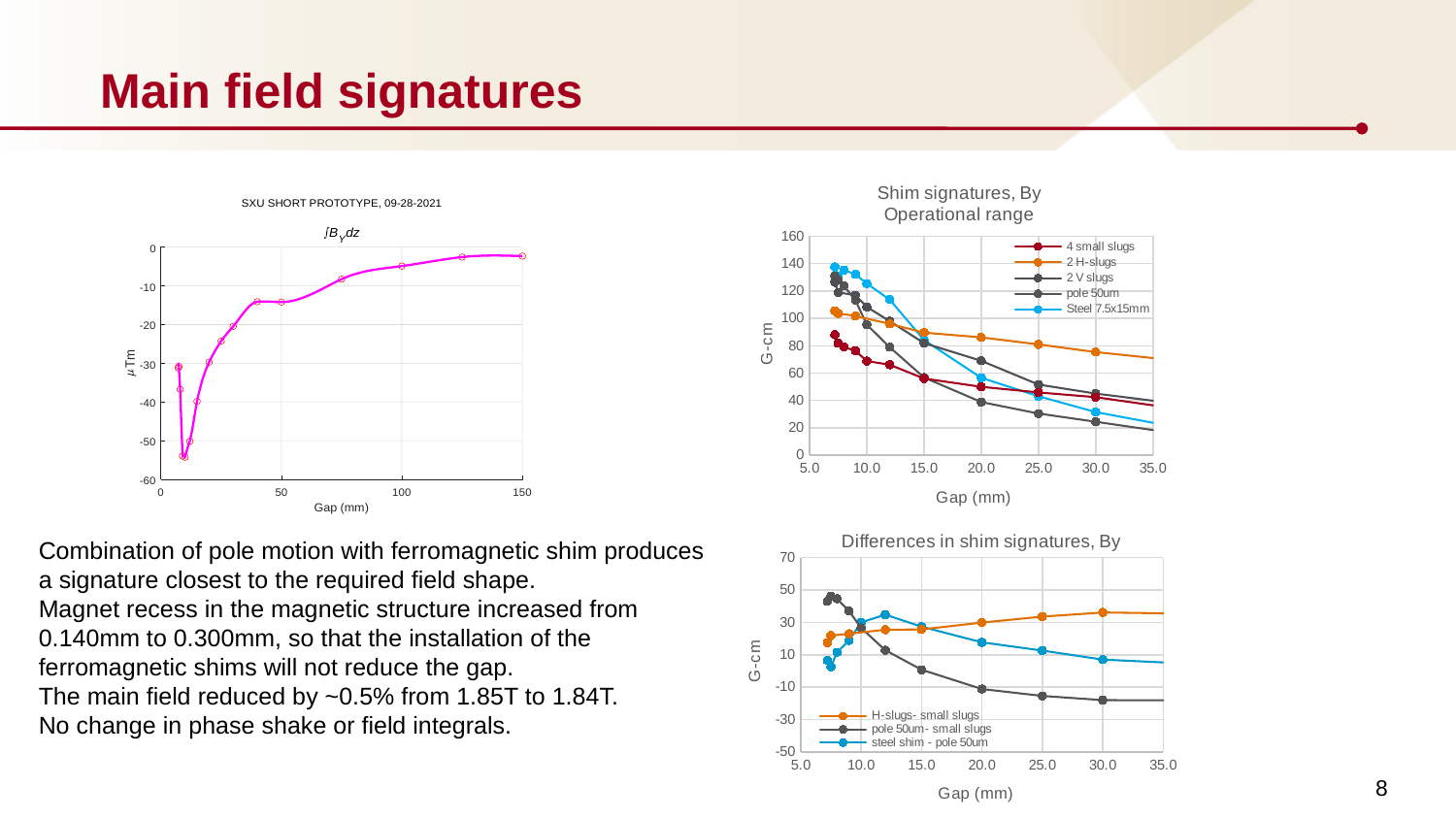
In the 'Differences in shim signatures, By' chart, is the value of the 'pole 50um- small slugs' series at a gap of 30.0 mm greater or less than -10? less In the 'SXU SHORT PROTOTYPE, 09-28-2021' chart, is the value at a gap of 100 mm greater or less than -10? greater What kind of chart is 'Differences in shim signatures, By'? line chart In the 'Differences in shim signatures, By' chart, does the 'H-slugs- small slugs' series rise or fall as the gap increases from 10.0 to 30.0 mm? rise In the 'Shim signatures, By Operational range' chart, is the value of the 4 small slugs series at a gap of 10.0 mm greater or less than 80? less In the 'Shim signatures, By Operational range' chart, which series has the highest value at a gap of 35.0 mm? 2 H-slugs What is the x-axis label of the 'SXU SHORT PROTOTYPE, 09-28-2021' chart? Gap (mm) In the 'Shim signatures, By Operational range' chart, at a gap of 15.0 mm, which is larger: the 2 H-slugs value or the 4 small slugs value? 2 H-slugs In the 'Shim signatures, By Operational range' chart, does the Steel 7.5x15mm series rise or fall as the gap increases? fall In the 'Differences in shim signatures, By' chart, how many series does the legend list? 3 In the 'Shim signatures, By Operational range' chart, how many series does the legend list? 5